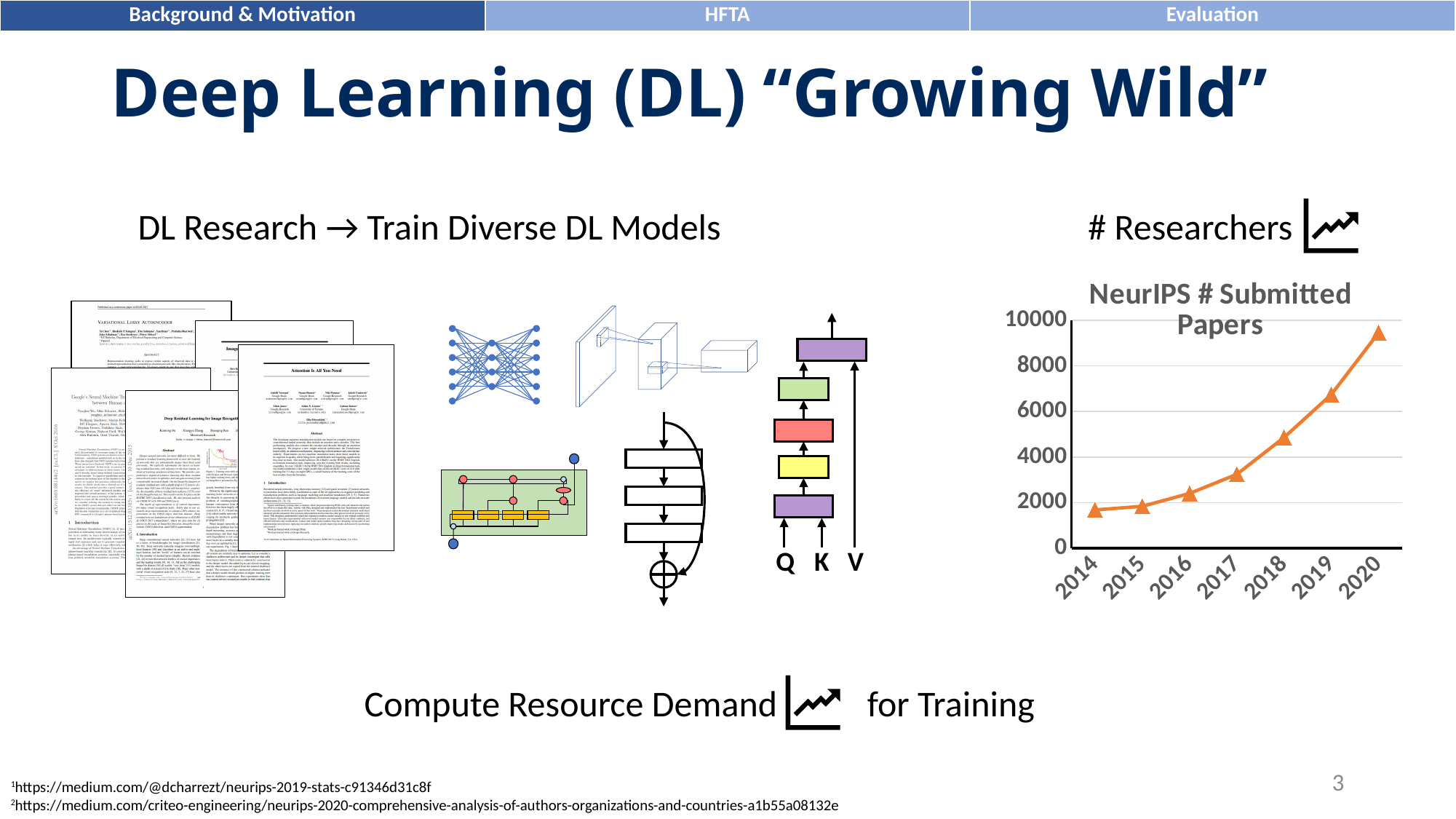
In the NeurIPS # Submitted Papers chart, is the value for 2014 greater or less than 2000? less In the NeurIPS # Submitted Papers chart, is the value for 2018 greater or less than 4000? greater Which year has the highest number of submitted papers in the NeurIPS # Submitted Papers chart? 2020 What is the title of the chart on the slide? NeurIPS # Submitted Papers Do the values in the NeurIPS # Submitted Papers chart rise or fall from 2014 to 2020? rise What kind of chart is the NeurIPS # Submitted Papers chart? line chart What colour is the line in the NeurIPS # Submitted Papers chart? orange In the NeurIPS # Submitted Papers chart, is the value for 2019 greater or less than 6000? greater How many years are plotted on the x axis of the NeurIPS # Submitted Papers chart? 7 In the NeurIPS # Submitted Papers chart, which year has the larger value, 2016 or 2019? 2019